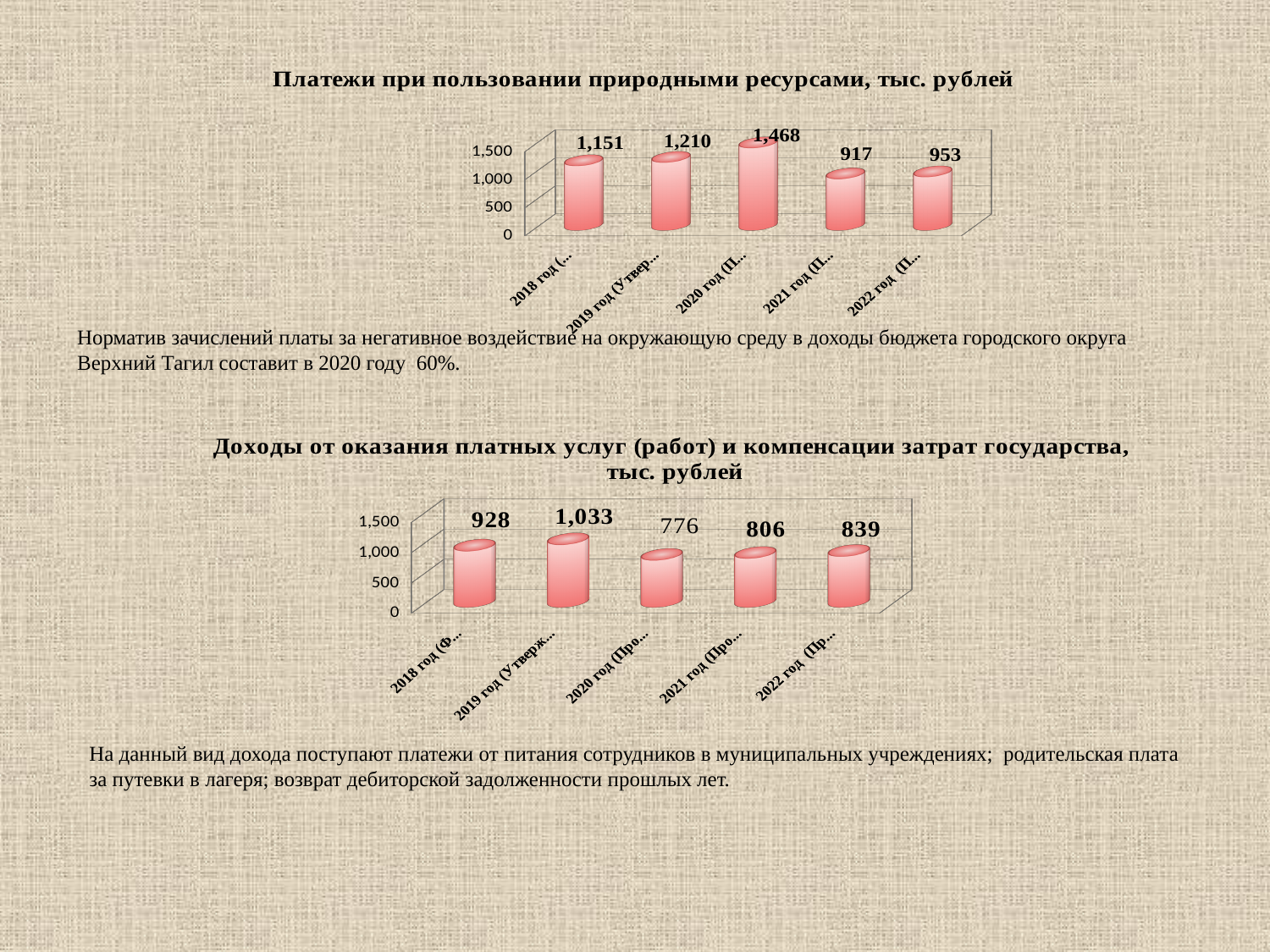
In the chart 'Доходы от оказания платных услуг (работ) и компенсации затрат государства, тыс. рублей', what is the value for 2020 год? 776 What kind of chart is the bottom chart on the slide? Bar chart In the chart 'Доходы от оказания платных услуг (работ) и компенсации затрат государства, тыс. рублей', what is the value for 2019 год? 1,033 In the chart 'Платежи при пользовании природными ресурсами, тыс. рублей', how many bars are plotted? 5 In the chart 'Платежи при пользовании природными ресурсами, тыс. рублей', what is the value for 2021 год? 917 In the chart 'Доходы от оказания платных услуг (работ) и компенсации затрат государства, тыс. рублей', which is larger, the value for 2018 год or 2022 год? 2018 год In the chart 'Платежи при пользовании природными ресурсами, тыс. рублей', which year has the lowest value? 2021 год In the chart 'Платежи при пользовании природными ресурсами, тыс. рублей', which year has the highest value? 2020 год In the chart 'Платежи при пользовании природными ресурсами, тыс. рублей', what is the difference between the values for 2019 год and 2018 год? 59 In the chart 'Доходы от оказания платных услуг (работ) и компенсации затрат государства, тыс. рублей', what is the difference between the values for 2022 год and 2021 год? 33 In the chart 'Платежи при пользовании природными ресурсами, тыс. рублей', what is the value for 2020 год? 1,468 In the chart 'Доходы от оказания платных услуг (работ) и компенсации затрат государства, тыс. рублей', which year has the lowest value? 2020 год